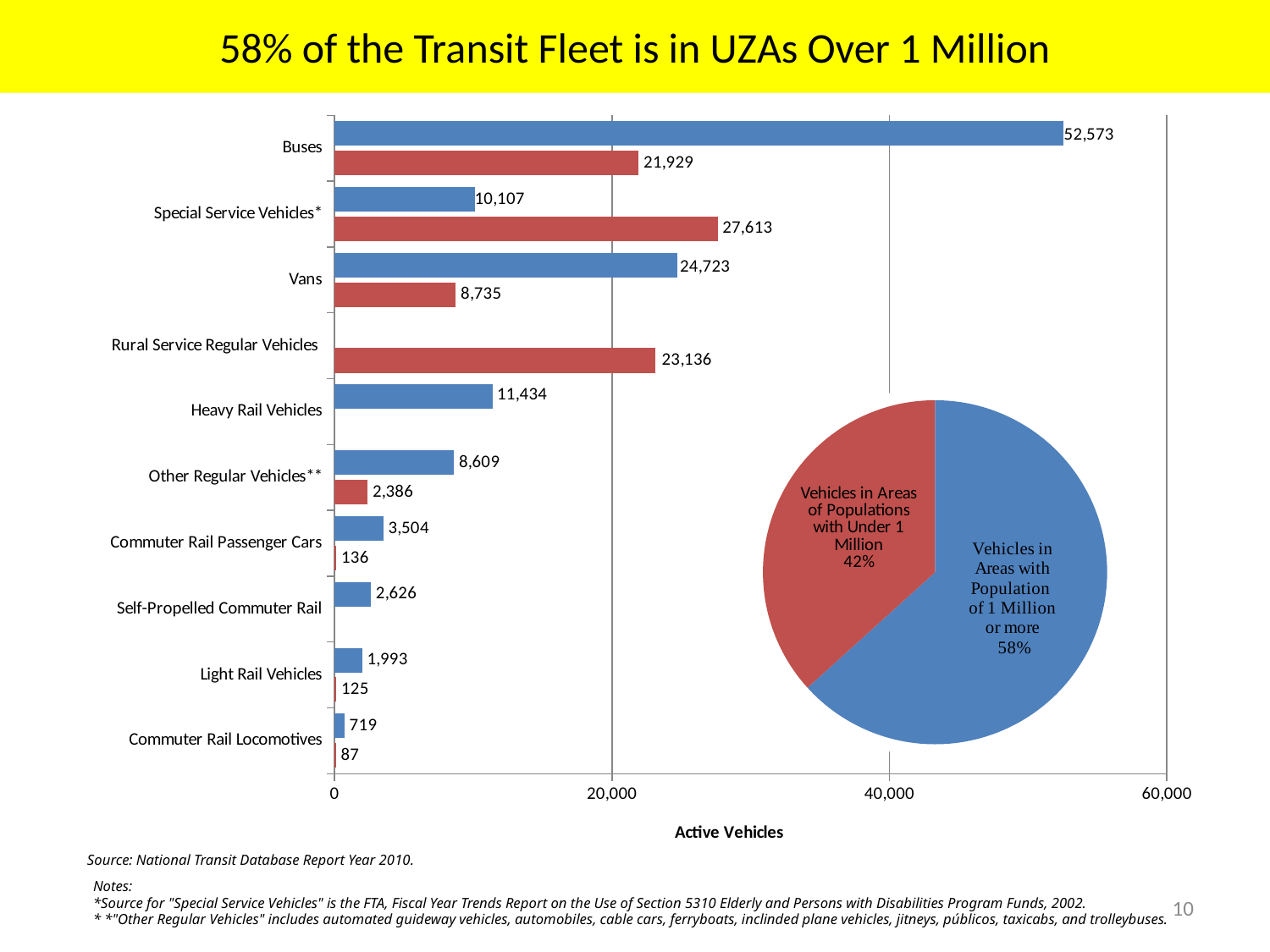
What kind of chart is the chart on the left side of the slide? Bar chart In the bar chart, which category has the smallest red bar value? Commuter Rail Locomotives In the bar chart, what is the difference between the blue bar and the red bar for Buses? 30,644 In the bar chart, which category has the longest blue bar? Buses In the bar chart, what is the value of the red bar for Rural Service Regular Vehicles? 23,136 In the bar chart, for Vans, is the blue bar or the red bar larger? Blue bar In the pie chart, what share is labelled for Vehicles in Areas with Population of 1 Million or more? 58% In the bar chart, what is the value of the blue bar for Buses? 52,573 In the bar chart, what is the value of the red bar for Special Service Vehicles*? 27,613 How many categories are shown on the bar chart? 10 What is the x-axis title of the bar chart? Active Vehicles In the bar chart, is the value of the blue bar for Heavy Rail Vehicles greater or less than 20,000? less